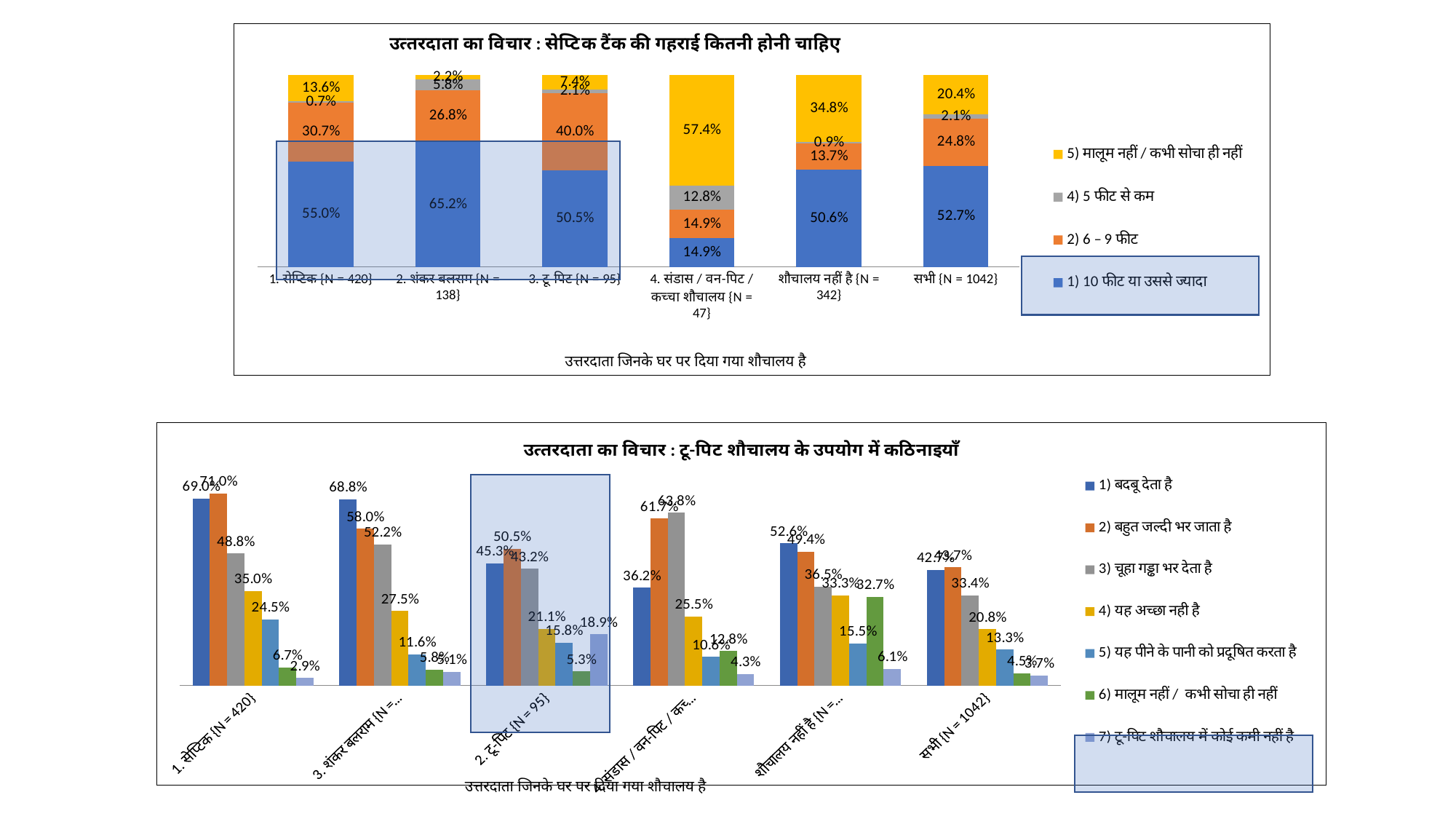
In the top chart (सेप्टिक टैंक की गहराई), what is the value of '5) मालूम नहीं / कभी सोचा ही नहीं' for '4. संडास / वन-पिट / कच्चा शौचालय'? 57.4% In the bottom chart (टू-पिट शौचालय के उपयोग में कठिनाइयाँ), how many series does the legend list? 7 In the bottom chart (टू-पिट शौचालय के उपयोग में कठिनाइयाँ), which is larger for '2. टू-पिट {N = 95}': '1) बदबू देता है' or '2) बहुत जल्दी भर जाता है'? 2) बहुत जल्दी भर जाता है In the top chart (सेप्टिक टैंक की गहराई), what is the value of '2) 6 – 9 फीट' for 'सभी {N = 1042}'? 24.8% In the bottom chart (टू-पिट शौचालय के उपयोग में कठिनाइयाँ), what is the value of '6) मालूम नहीं / कभी सोचा ही नहीं' for 'शौचालय नहीं है'? 32.7% In the top chart (सेप्टिक टैंक की गहराई), what is the difference between the '2) 6 – 9 फीट' values for '3. टू पिट' and '1. सेप्टिक'? 9.3% In the top chart (सेप्टिक टैंक की गहराई), what is the value of '1) 10 फीट या उससे ज्यादा' for '2. शंकर बलराम'? 65.2% What kind of chart is the top chart (सेप्टिक टैंक की गहराई)? Stacked bar chart In the top chart (सेप्टिक टैंक की गहराई), which category has the lowest value for '1) 10 फीट या उससे ज्यादा'? 4. संडास / वन-पिट / कच्चा शौचालय In the top chart (सेप्टिक टैंक की गहराई), which category has the highest value for '1) 10 फीट या उससे ज्यादा'? 2. शंकर बलराम In the top chart (सेप्टिक टैंक की गहराई), how many series does the legend list? 4 In the bottom chart (टू-पिट शौचालय के उपयोग में कठिनाइयाँ), what is the value of '2) बहुत जल्दी भर जाता है' for '1. सेप्टिक {N = 420}'? 71.0%